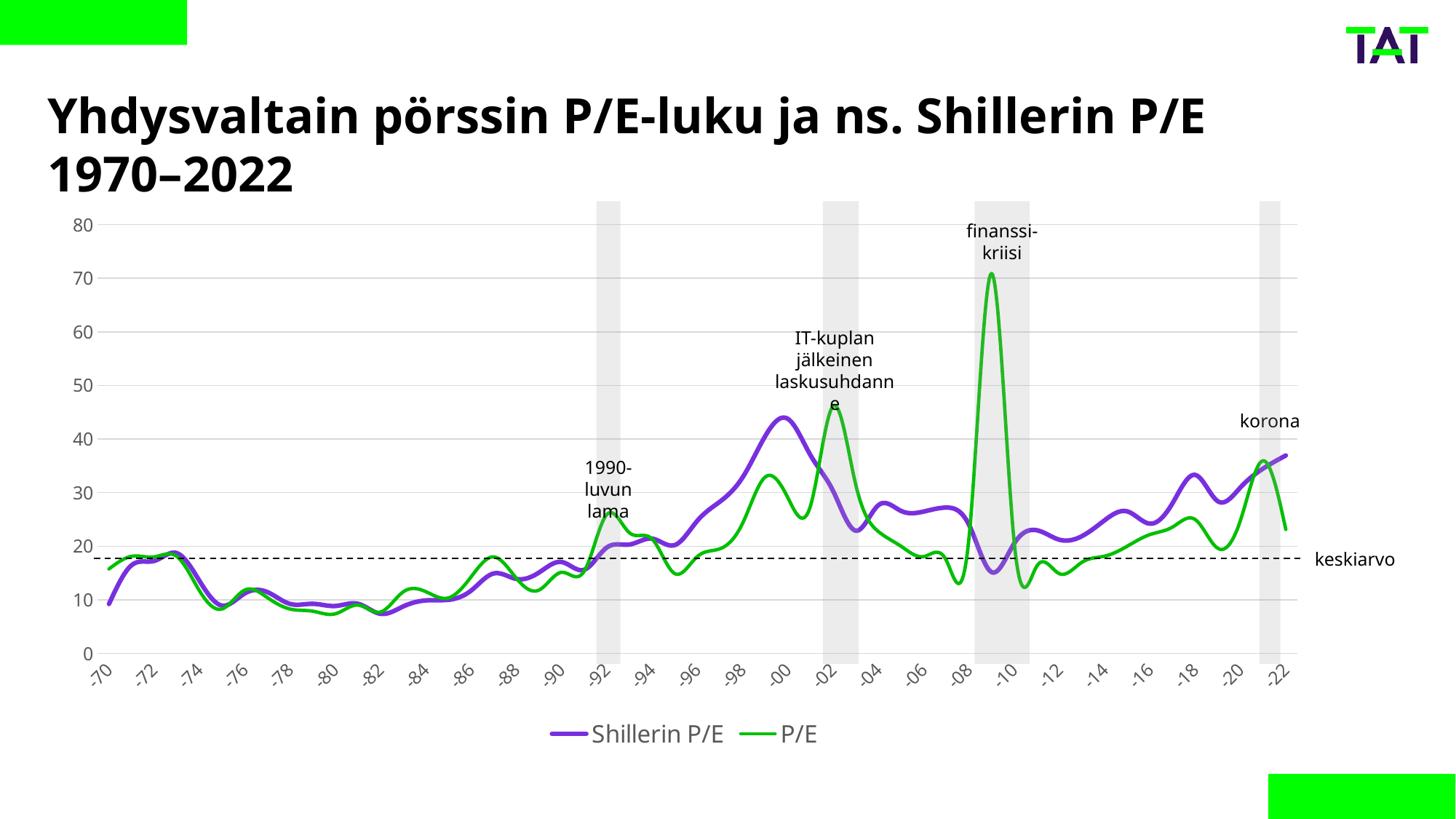
What kind of chart is shown on the slide? line chart What is the title of the chart on the slide? Yhdysvaltain pörssin P/E-luku ja ns. Shillerin P/E 1970–2022 Is the value of Shillerin P/E at -22 greater or less than 30? greater At -09, which series has the larger value, Shillerin P/E or P/E? P/E Is the peak value of the P/E series during the finanssikriisi greater or less than 60? greater Does the Shillerin P/E series rise or fall between -12 and -18? rise Is the value of Shillerin P/E at -00 greater or less than 40? greater How many series does the legend list? 2 Which series reaches the highest value anywhere on the chart? P/E What are the two series named in the legend? Shillerin P/E and P/E At -00, which series has the larger value, Shillerin P/E or P/E? Shillerin P/E